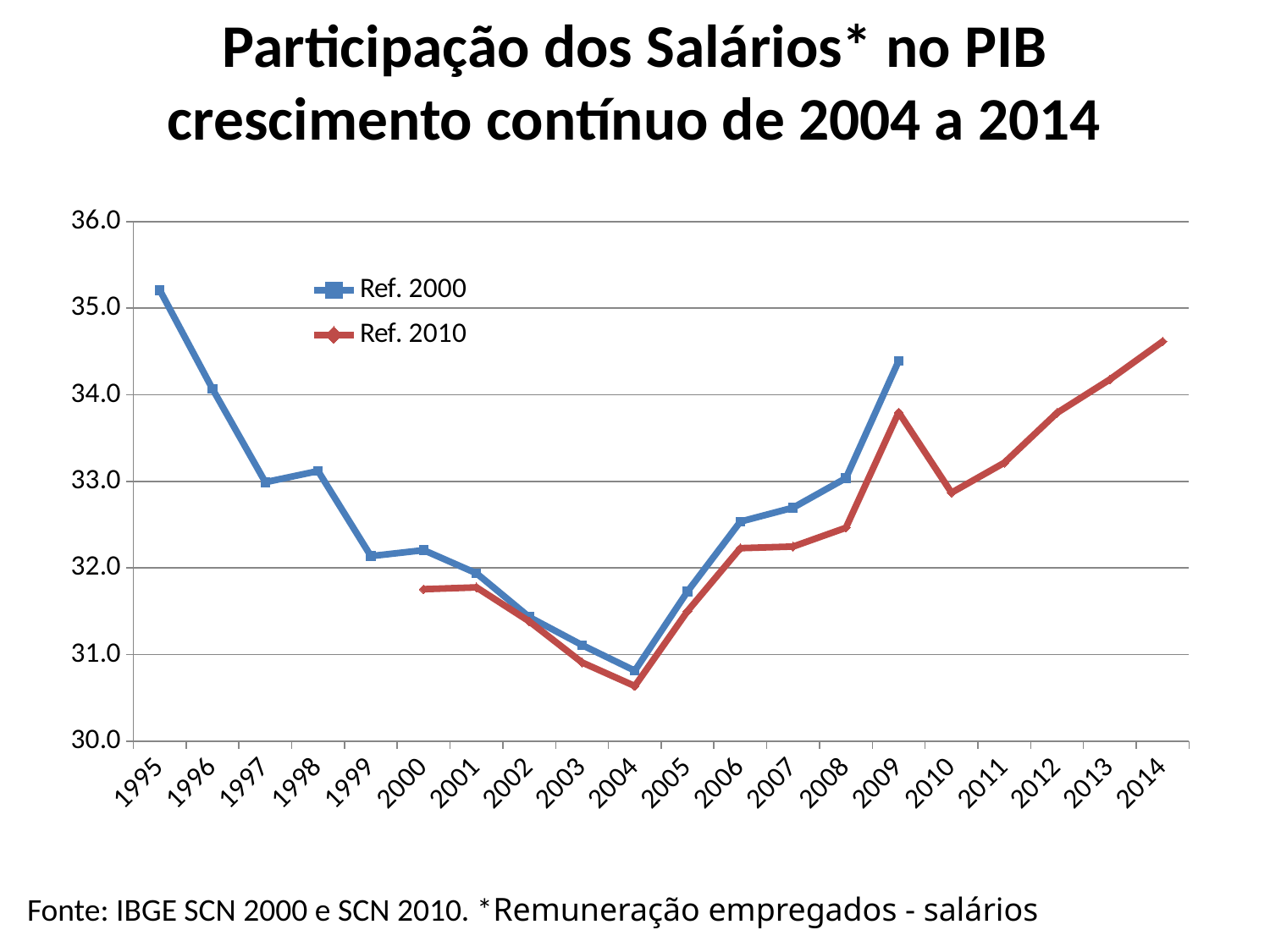
In which year is the Ref. 2000 series at its highest? 1995 What kind of chart is shown on the slide? line chart Is the Ref. 2010 value for 2004 greater or less than 31.0? less How many years are shown on the x axis? 20 What are the two series named in the legend? Ref. 2000 and Ref. 2010 Does the Ref. 2010 series rise or fall from 2010 to 2014? rise In 2009, which series has the higher value, Ref. 2000 or Ref. 2010? Ref. 2000 In which year is the Ref. 2010 series at its highest? 2014 In which year is the Ref. 2000 series at its lowest? 2004 How many series does the legend list? 2 Is the Ref. 2000 value for 1995 greater or less than 34.0? greater In which year is the Ref. 2010 series at its lowest? 2004